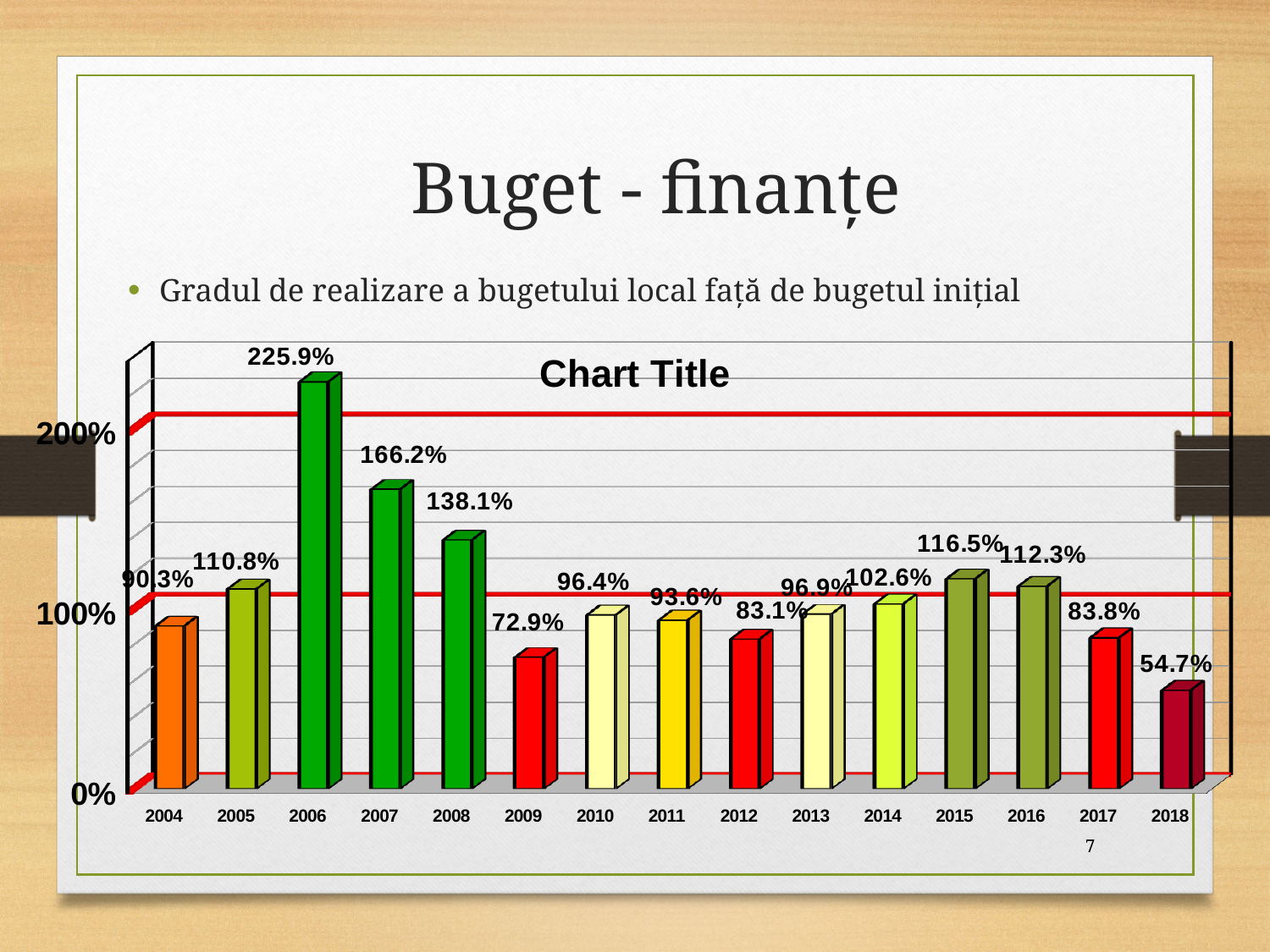
What is the value for 2006? 225.9% What is the difference between the values for 2007 and 2008? 28.1% Which year has the highest value? 2006 What is the value for 2009? 72.9% What is the value for 2014? 102.6% Is the value for 2005 greater or less than 100%? greater What is the value for 2018? 54.7% Which is larger, the value for 2015 or the value for 2016? 2015 What is the title printed on the chart? Chart Title Which year has the lowest value? 2018 How many years are shown on the x axis? 15 What kind of chart is shown on the slide? bar chart